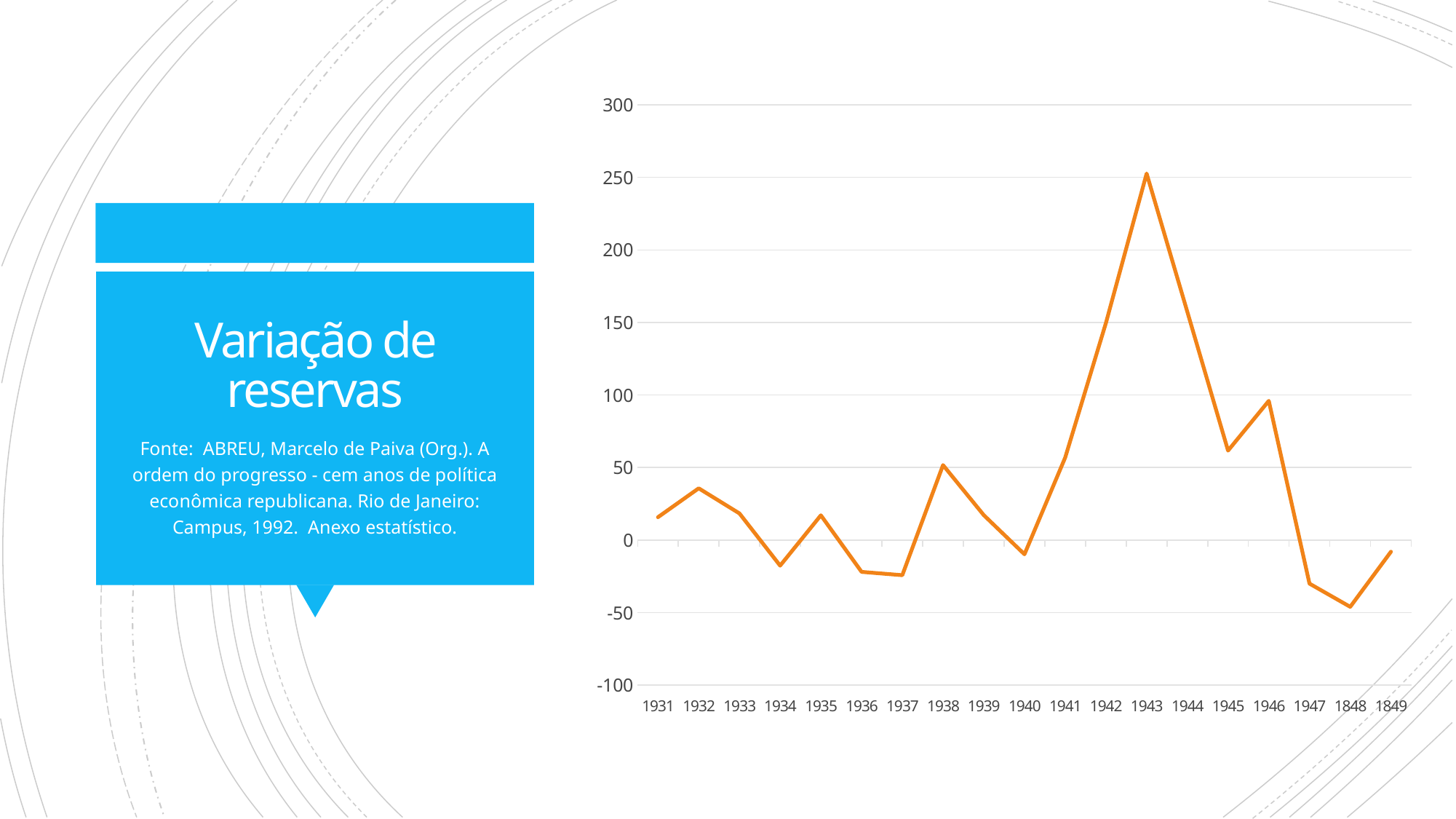
Which x-axis label corresponds to the lowest point on the line? 1848 Is the value for 1943 greater or less than 200? greater Is the value for 1937 greater or less than 0? less What is the title shown in the blue box next to the chart? Variação de reservas What kind of chart is shown on the slide? line chart Is the value for 1947 greater or less than 0? less Which year has the larger value, 1940 or 1941? 1941 Which year has the larger value, 1943 or 1946? 1943 How many years are plotted along the x axis of the chart? 19 In which year does the line reach its highest value? 1943 Do the values rise or fall from 1943 to 1945? fall